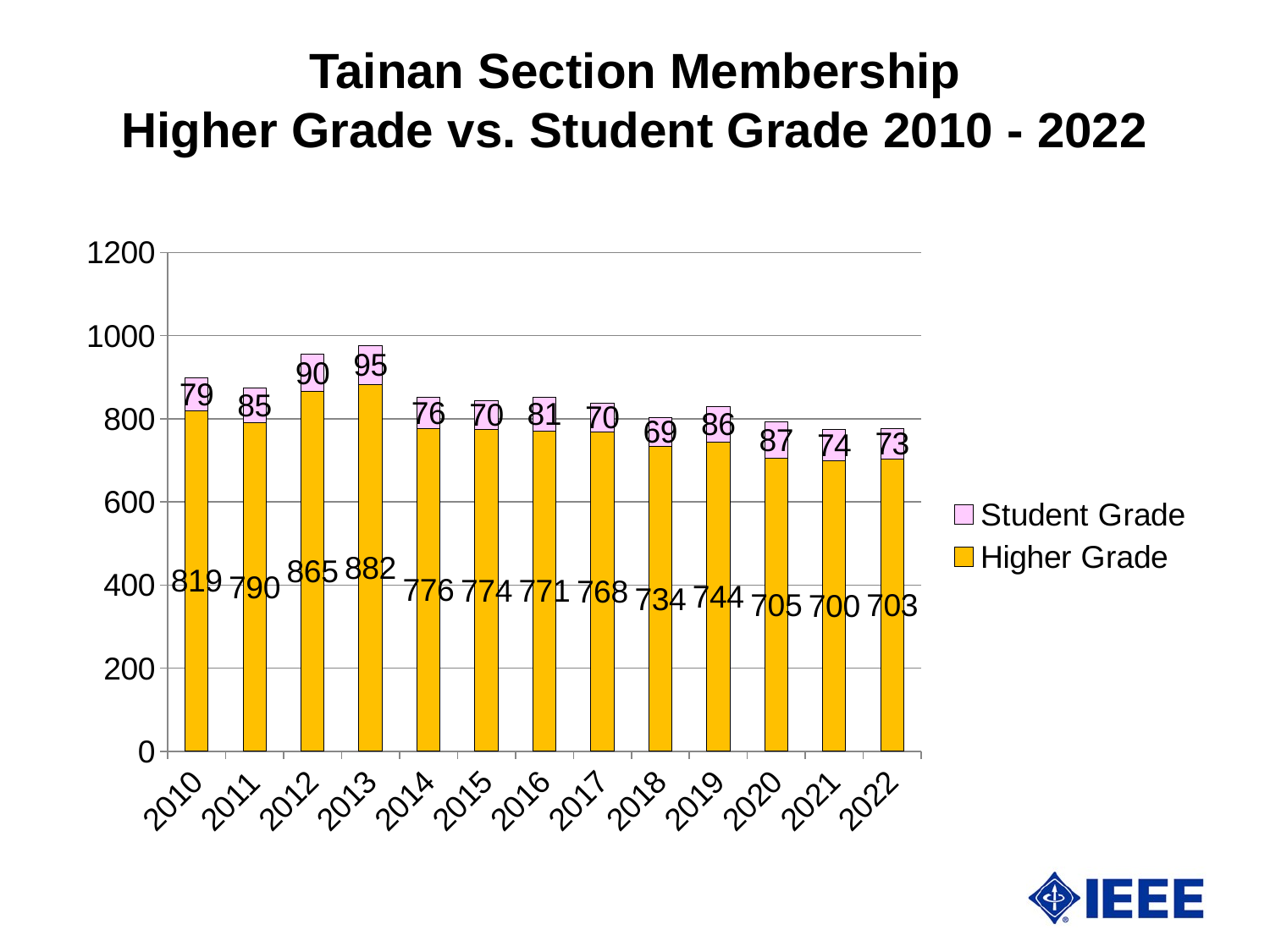
What is the Student Grade membership value for 2019? 86 What is the total membership (Higher Grade plus Student Grade) for 2013? 977 What is the Higher Grade membership value for 2013? 882 Which year has the lowest Student Grade membership? 2018 Which is larger, the Student Grade value for 2020 or for 2021? 2020 What is the difference between the Higher Grade values for 2013 and 2012? 17 What kind of chart is shown on the slide? Stacked bar chart What is the total membership (Higher Grade plus Student Grade) for 2022? 776 Which year has the highest Higher Grade membership? 2013 How many series does the legend list? 2 Which year has the lowest Higher Grade membership? 2021 How many years are shown on the x axis? 13